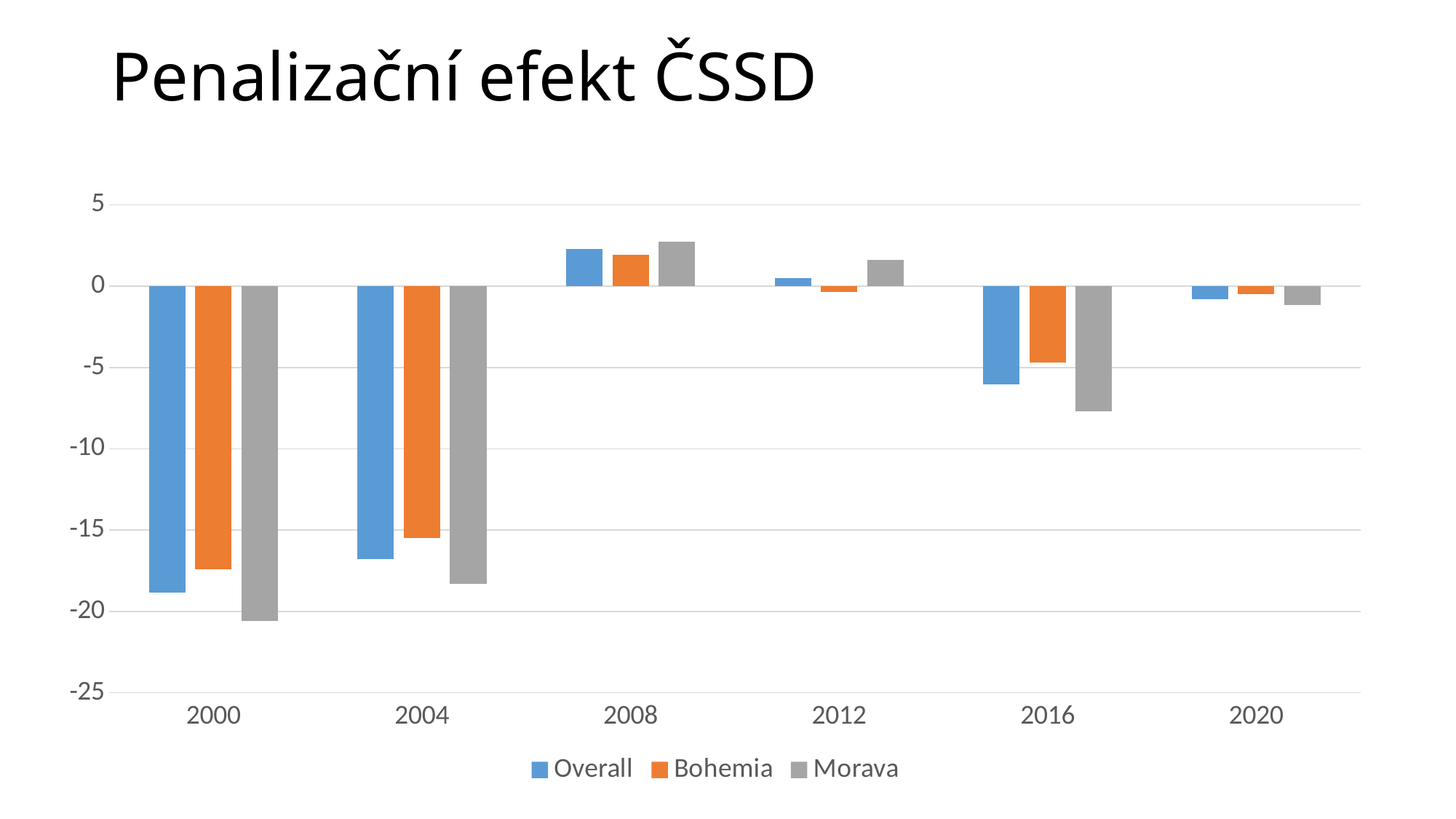
Is the Overall value for 2000 greater or less than -15? less Is the Morava value for 2016 greater or less than -5? less Do the Overall values rise or fall from 2000 to 2008? rise What kind of chart is shown on the slide? bar chart In 2016, which is larger, the Bohemia value or the Morava value? Bohemia In 2000, which is larger, the Overall value or the Bohemia value? Bohemia How many series does the legend list? 3 In which year is the Morava value highest? 2008 Is the Bohemia value for 2004 greater or less than -20? greater In which year is the Morava value lowest? 2000 What is the title of the slide? Penalizační efekt ČSSD How many years are shown on the x axis? 6